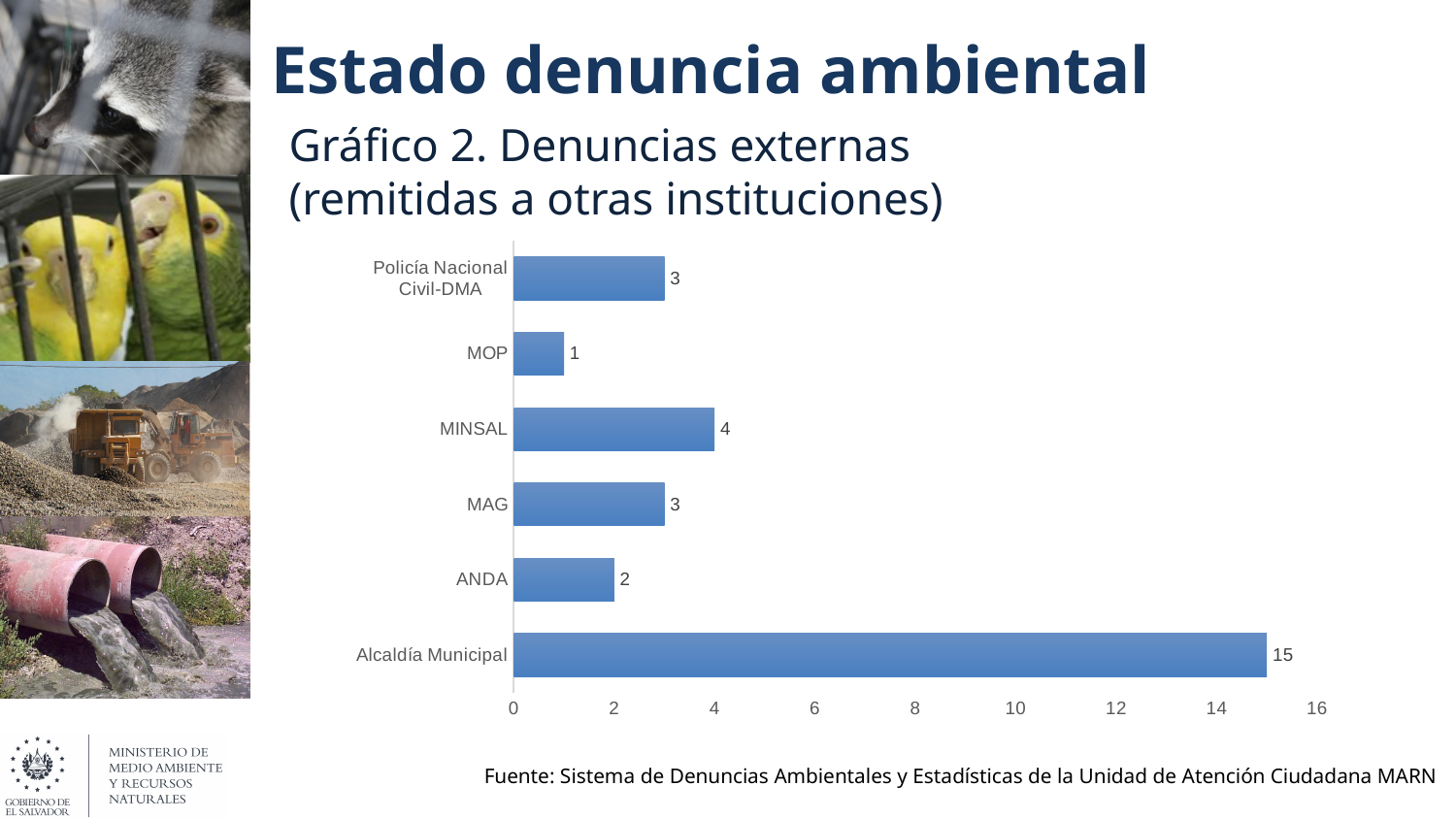
How many categories are shown in the chart? 6 Is the value for Alcaldía Municipal greater or less than 10? greater What is the difference between the values for Alcaldía Municipal and MINSAL? 11 Which category has the lowest value? MOP What kind of chart is shown on the slide? bar chart What is the value for MOP? 1 What is the title of the chart? Gráfico 2. Denuncias externas (remitidas a otras instituciones) Which is larger, the value for ANDA or the value for MAG? MAG What is the value for MINSAL? 4 What is the value for Alcaldía Municipal? 15 Which category has the highest value? Alcaldía Municipal What is the value for Policía Nacional Civil-DMA? 3